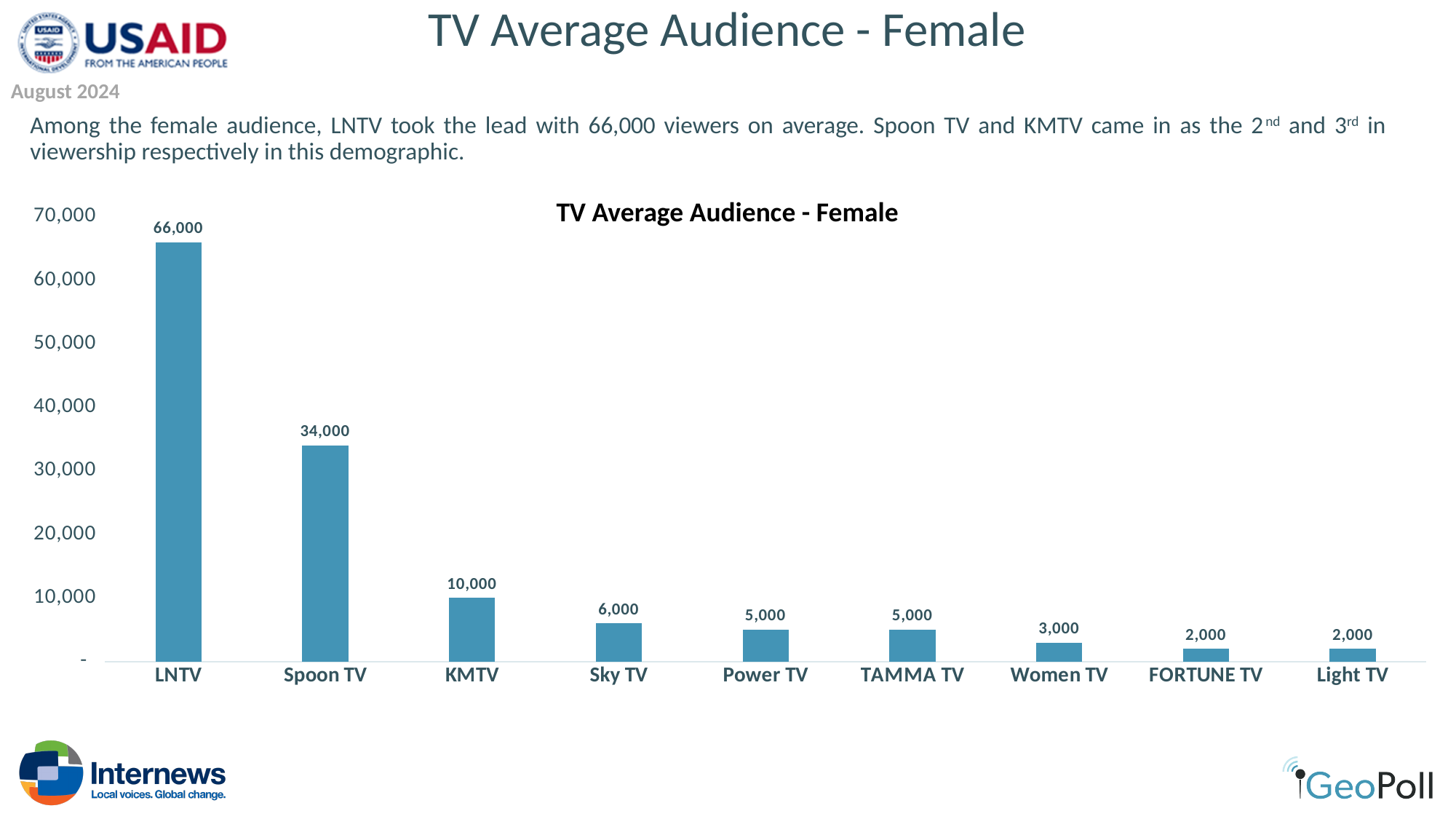
What is the difference between the average female audience of KMTV and Sky TV? 4,000 Is the value for Spoon TV greater or less than 30,000? greater Which has a larger average female audience, Sky TV or Power TV? Sky TV What is the difference between the average female audience of LNTV and Spoon TV? 32,000 What is the average female audience for Women TV? 3,000 What is the title of the chart? TV Average Audience - Female How many TV stations are shown on the chart? 9 What is the average female audience for KMTV? 10,000 What is the average female audience for Spoon TV? 34,000 Which TV station has the highest average female audience? LNTV What is the average female audience for LNTV? 66,000 What kind of chart is shown on the slide? Bar chart